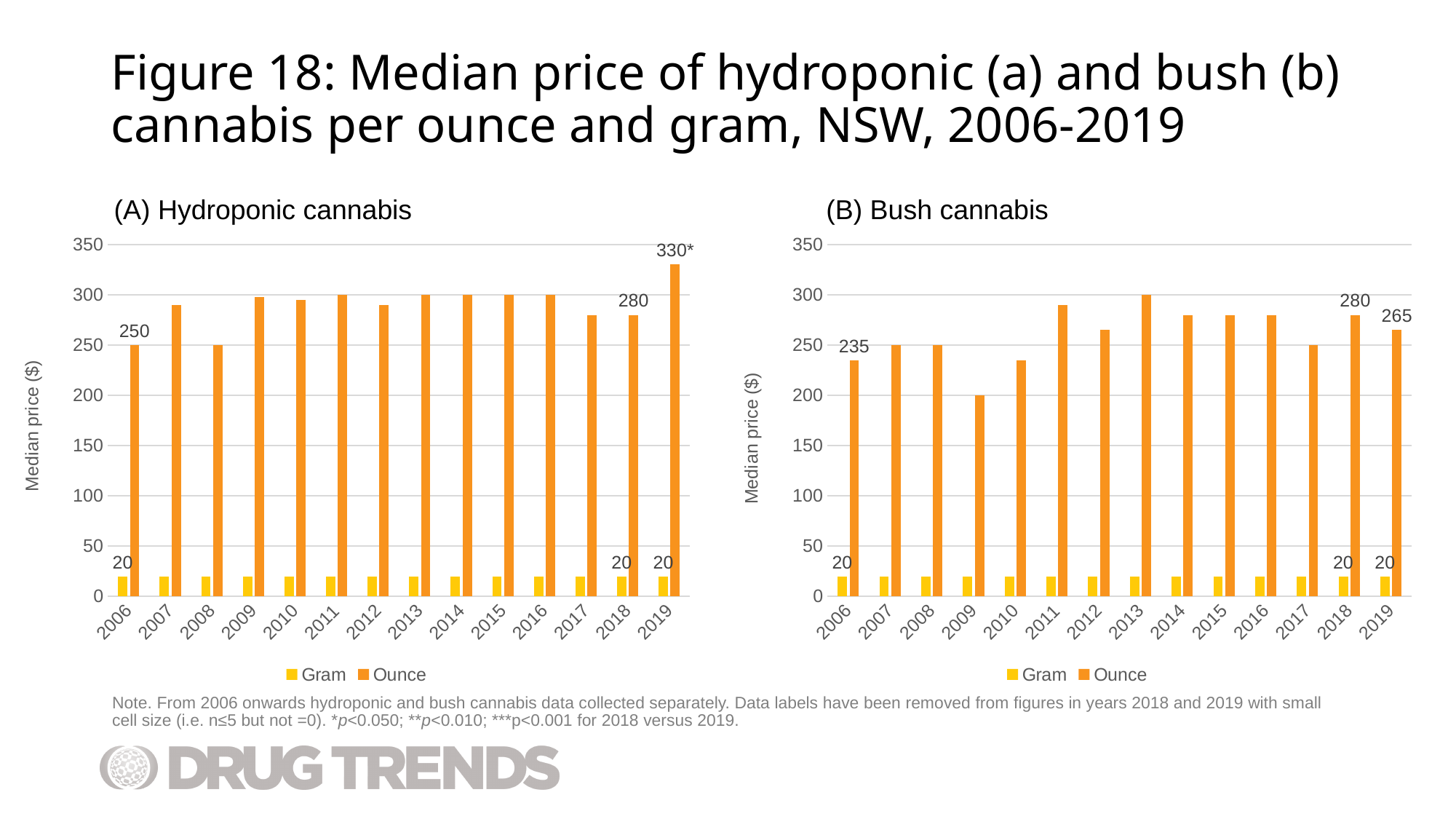
In the (B) Bush cannabis chart, what is the median price per ounce in 2019? 265 In the (A) Hydroponic cannabis chart, by how much did the median ounce price change from 2018 to 2019? 50 In the (A) Hydroponic cannabis chart, what is the median price per ounce in 2019? 330* Which is larger: the 2019 median ounce price for hydroponic cannabis in chart (A) or for bush cannabis in chart (B)? Hydroponic cannabis (A) In the (B) Bush cannabis chart, what is the difference between the median ounce price in 2018 and in 2019? 15 In the (B) Bush cannabis chart, what is the median price per ounce in 2006? 235 In the (B) Bush cannabis chart, is the median ounce price in 2009 greater or less than 250? less In the (A) Hydroponic cannabis chart, which year has the highest median price per ounce? 2019 How many series does the legend of the (B) Bush cannabis chart list? 2 In the (B) Bush cannabis chart, which year has the lowest median price per ounce? 2009 How many years are shown on the x axis of the (A) Hydroponic cannabis chart? 14 In the (A) Hydroponic cannabis chart, what is the median price per ounce in 2006? 250